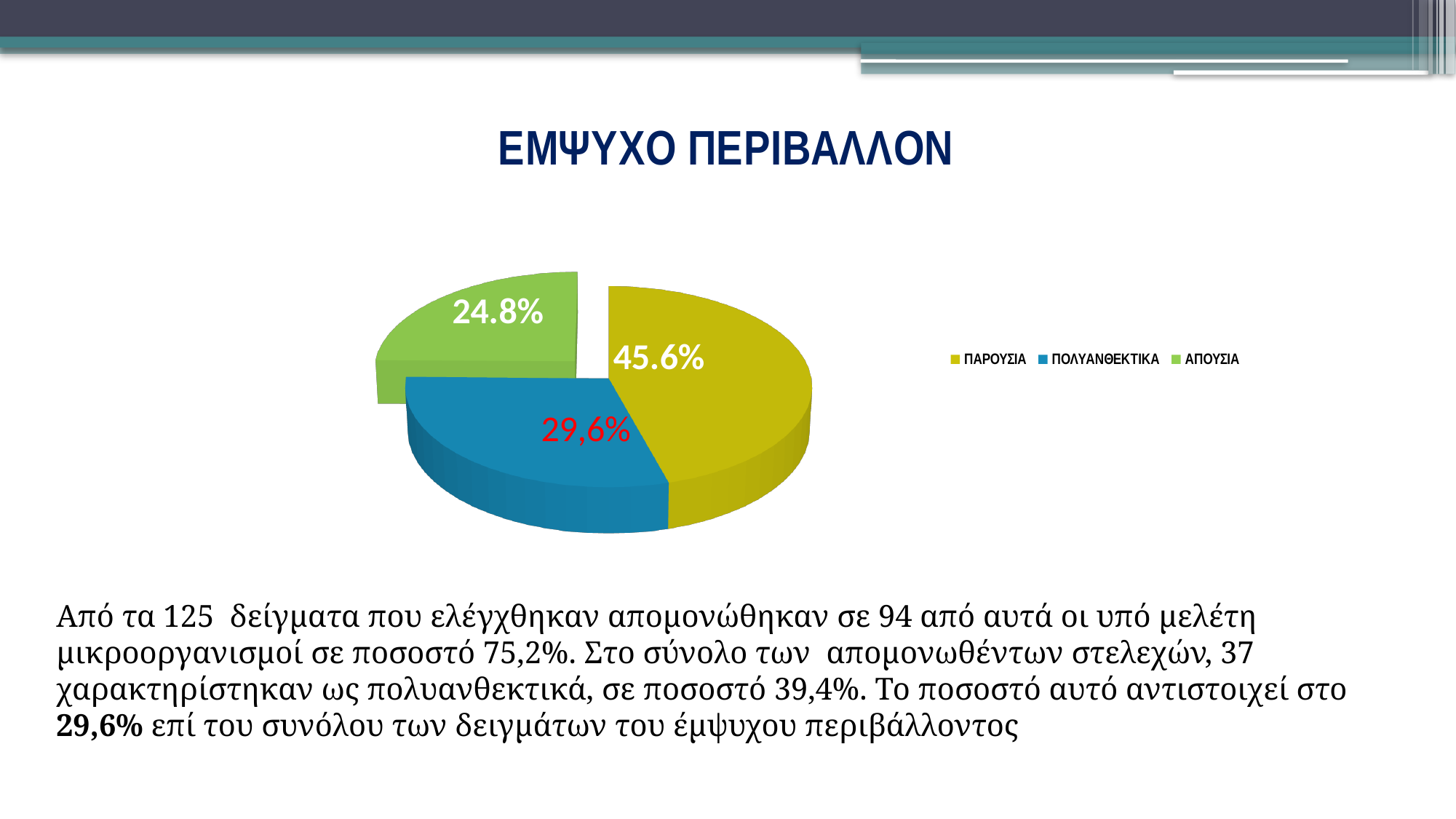
What kind of chart is shown on the slide? Pie chart How many entries does the legend of the pie chart list? 3 What percentage is shown for ΑΠΟΥΣΙΑ in the pie chart? 24.8% By how many percentage points does the ΠΑΡΟΥΣΙΑ slice exceed the ΑΠΟΥΣΙΑ slice? 20.8 percentage points What is the title of the chart on the slide? ΕΜΨΥΧΟ ΠΕΡΙΒΑΛΛΟΝ What percentage is shown for ΠΑΡΟΥΣΙΑ in the pie chart? 45.6% Which colour represents ΠΟΛΥΑΝΘΕΚΤΙΚΑ in the pie chart? Blue Which slice is larger in the pie chart, ΠΟΛΥΑΝΘΕΚΤΙΚΑ or ΑΠΟΥΣΙΑ? ΠΟΛΥΑΝΘΕΚΤΙΚΑ What percentage is shown for ΠΟΛΥΑΝΘΕΚΤΙΚΑ in the pie chart? 29,6% How many slices does the pie chart have? 3 Which category has the largest slice in the pie chart? ΠΑΡΟΥΣΙΑ Which category has the smallest slice in the pie chart? ΑΠΟΥΣΙΑ